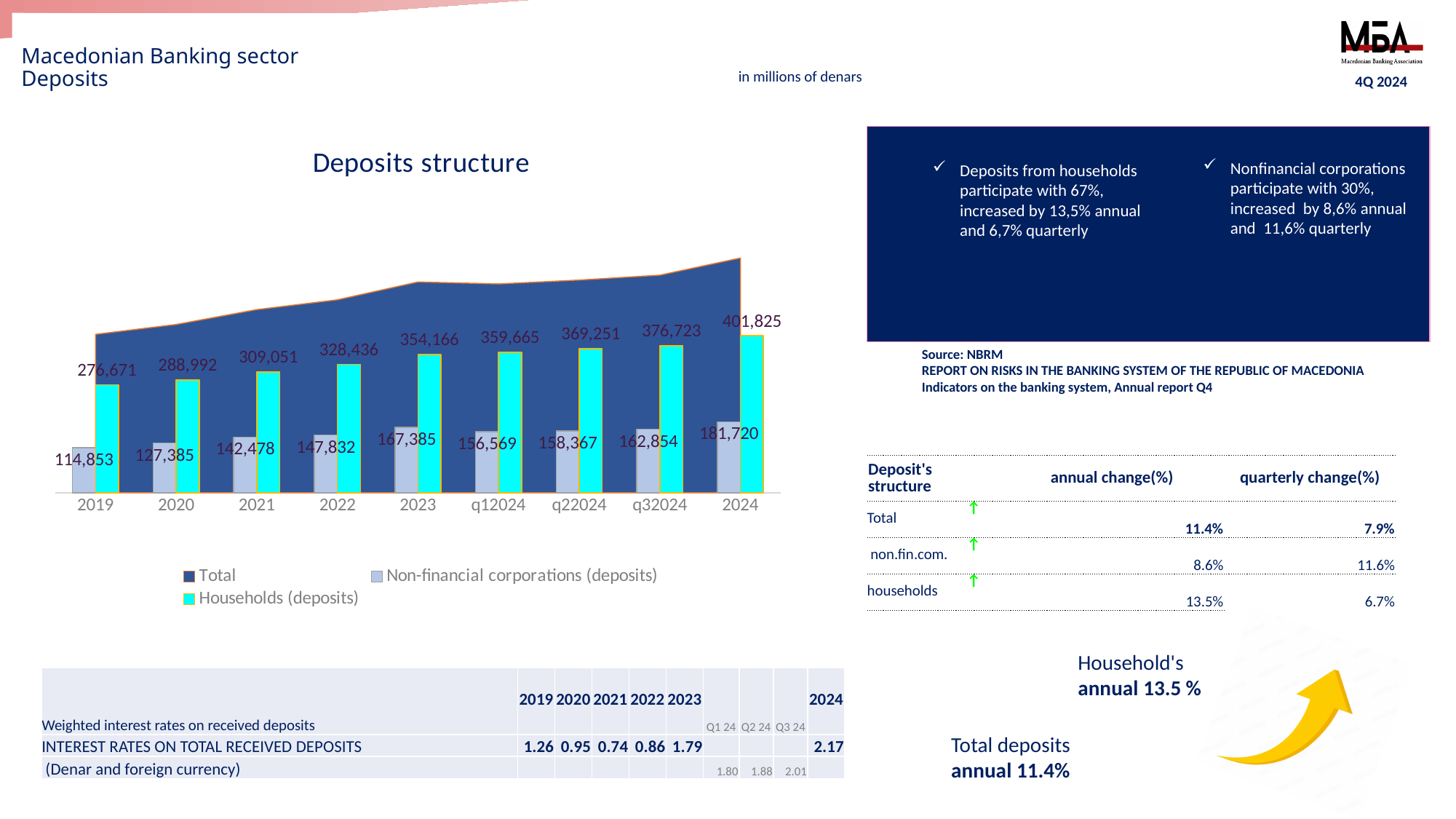
How many series does the legend of the Deposits structure chart list? 3 How many categories are shown on the x axis of the Deposits structure chart? 9 In the Deposits structure chart, do the Households (deposits) values rise or fall from 2019 to 2024? rise In the Deposits structure chart, which category has the highest value for Households (deposits)? 2024 In the Deposits structure chart, which is larger for Non-financial corporations (deposits): 2023 or q12024? 2023 What kind of chart is used to show Households (deposits) in the Deposits structure chart? bar chart In the Deposits structure chart, what is the value of Households (deposits) for 2024? 401,825 In the Deposits structure chart, what is the value of Non-financial corporations (deposits) for q32024? 162,854 In the Deposits structure chart, what is the value of Households (deposits) for 2021? 309,051 In the Deposits structure chart, what is the difference between the Households (deposits) values for 2024 and 2019? 125,154 In the Deposits structure chart, what is the value of Non-financial corporations (deposits) for 2019? 114,853 In the Deposits structure chart, which category has the lowest value for Non-financial corporations (deposits)? 2019